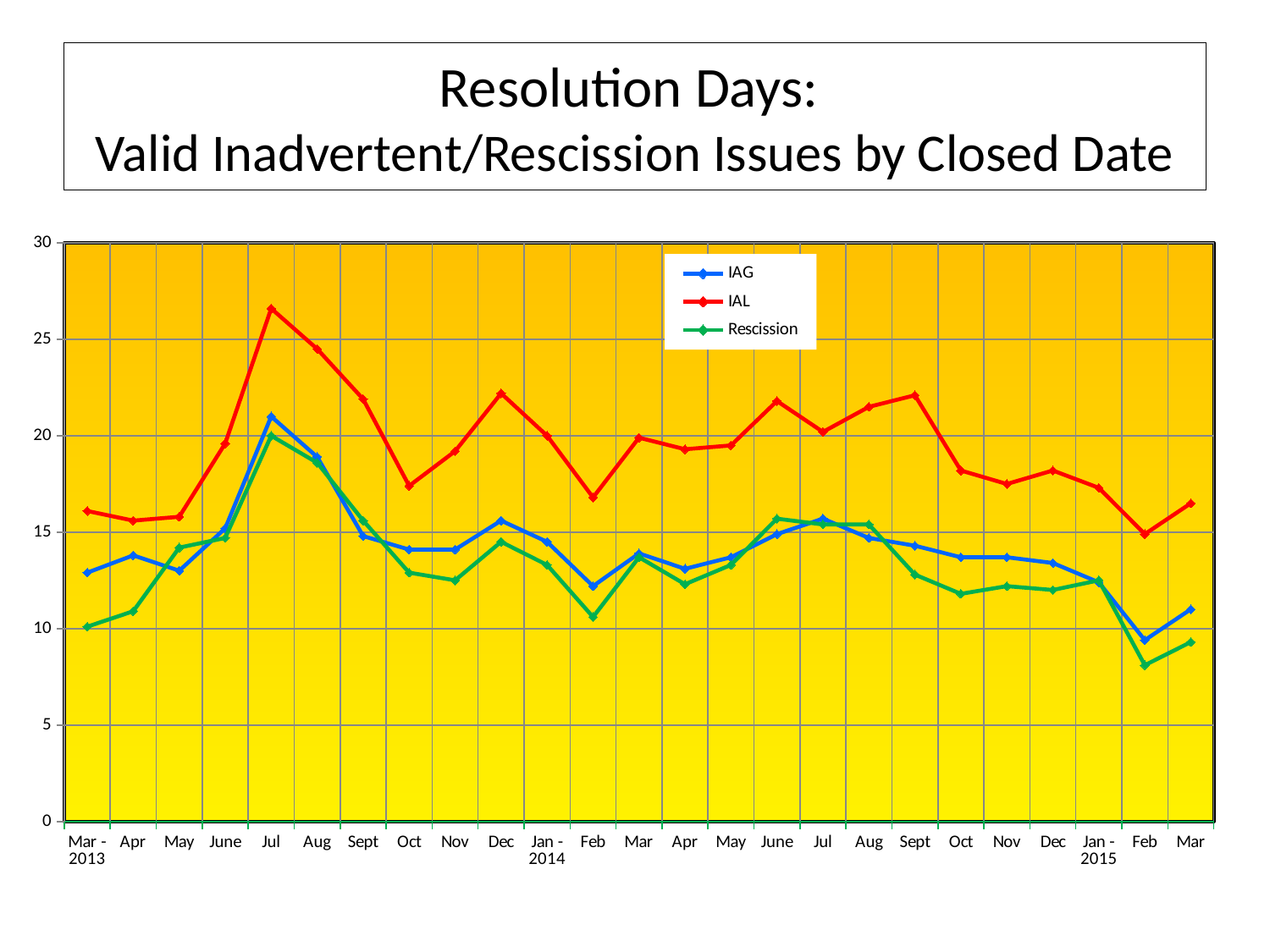
What kind of chart is shown on the slide? line chart How many monthly data points are plotted along the x axis? 25 Is the Rescission value for Feb 2015 greater or less than 10? less Does the IAL series rise or fall from Jul 2013 to Oct 2013? fall Is the IAL value for Jul 2013 greater or less than 25? greater In which month does the IAL series reach its highest value? Jul 2013 In which month does the Rescission series reach its lowest value? Feb 2015 Which series is drawn in red? IAL Which series has the larger value in Apr 2013, IAG or Rescission? IAG In which month does the IAG series reach its highest value? Jul 2013 Is the IAL value for Dec 2013 greater or less than 20? greater How many series does the legend list? 3